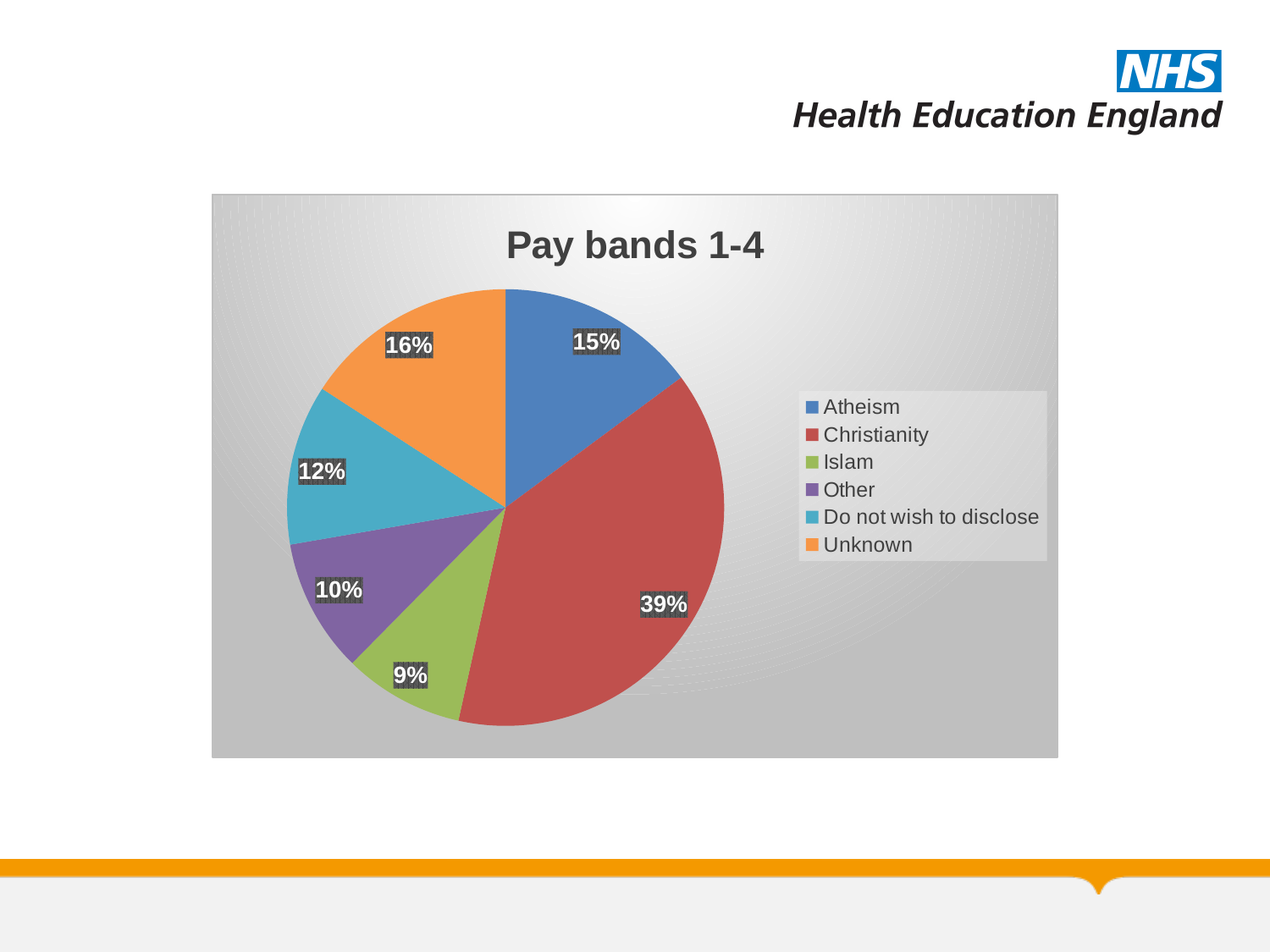
What percentage of the pie is Christianity? 39% How many categories does the legend list? 6 Which category has the largest slice of the pie? Christianity Which is larger, the Unknown slice or the Other slice? Unknown What percentage of the pie is Do not wish to disclose? 12% What is the difference in percentage points between Christianity and Atheism? 24 What percentage of the pie is Unknown? 16% What is the title of the chart? Pay bands 1-4 What percentage of the pie is Atheism? 15% Which category has the smallest slice of the pie? Islam What type of chart is shown on the slide? pie chart What percentage of the pie is Islam? 9%